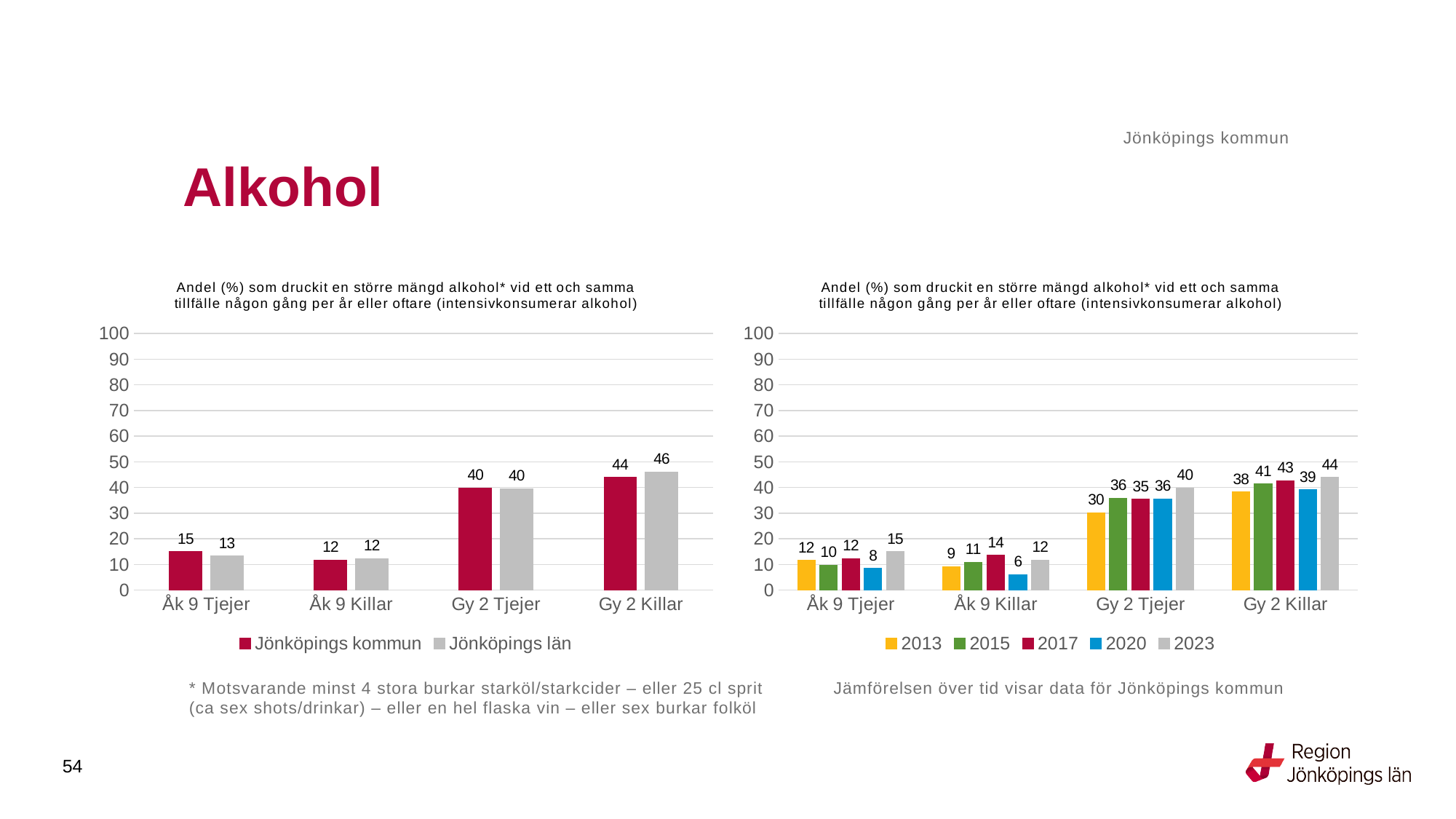
In the right chart, what is the difference between the 2023 and 2013 values for Gy 2 Tjejer? 10 What kind of chart is the right chart? Bar chart In the left chart, what is the value for Jönköpings kommun for Gy 2 Killar? 44 In the right chart, how many series does the legend list? 5 In the left chart, which category has the highest value for Jönköpings län? Gy 2 Killar In the left chart, what is the value for Jönköpings län for Åk 9 Tjejer? 13 In the left chart, what is the difference between Jönköpings län and Jönköpings kommun for Gy 2 Killar? 2 In the right chart, is the value for 2013 for Gy 2 Killar larger or smaller than the value for 2023 for Gy 2 Killar? smaller In the right chart, what is the value for 2023 for Gy 2 Tjejer? 40 In the left chart, how many series does the legend list? 2 In the right chart, what is the value for 2020 for Åk 9 Killar? 6 In the right chart, which year has the lowest value for Åk 9 Tjejer? 2020